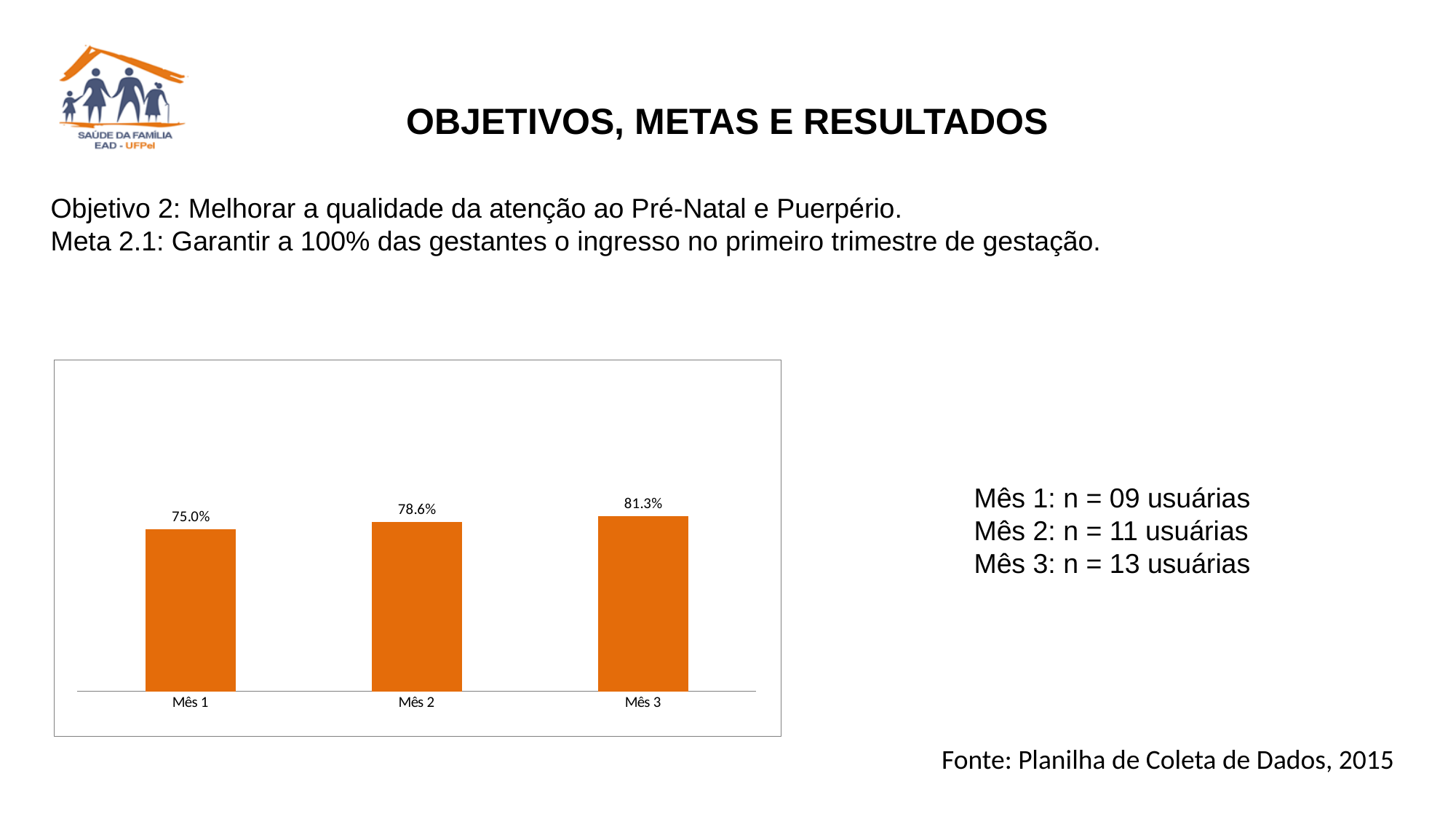
What colour are the bars in the chart? Orange What is the value for Mês 2? 78.6% Do the values rise or fall from Mês 1 to Mês 3? Rise What is the value for Mês 3? 81.3% Which month has the highest value? Mês 3 What is the difference between the values for Mês 3 and Mês 1? 6.3% How many bars are shown in the chart? 3 What kind of chart is shown on the slide? Bar chart Which is larger, the value for Mês 2 or the value for Mês 3? Mês 3 What is the difference between the values for Mês 2 and Mês 1? 3.6% What is the value for Mês 1? 75.0% Which month has the lowest value? Mês 1